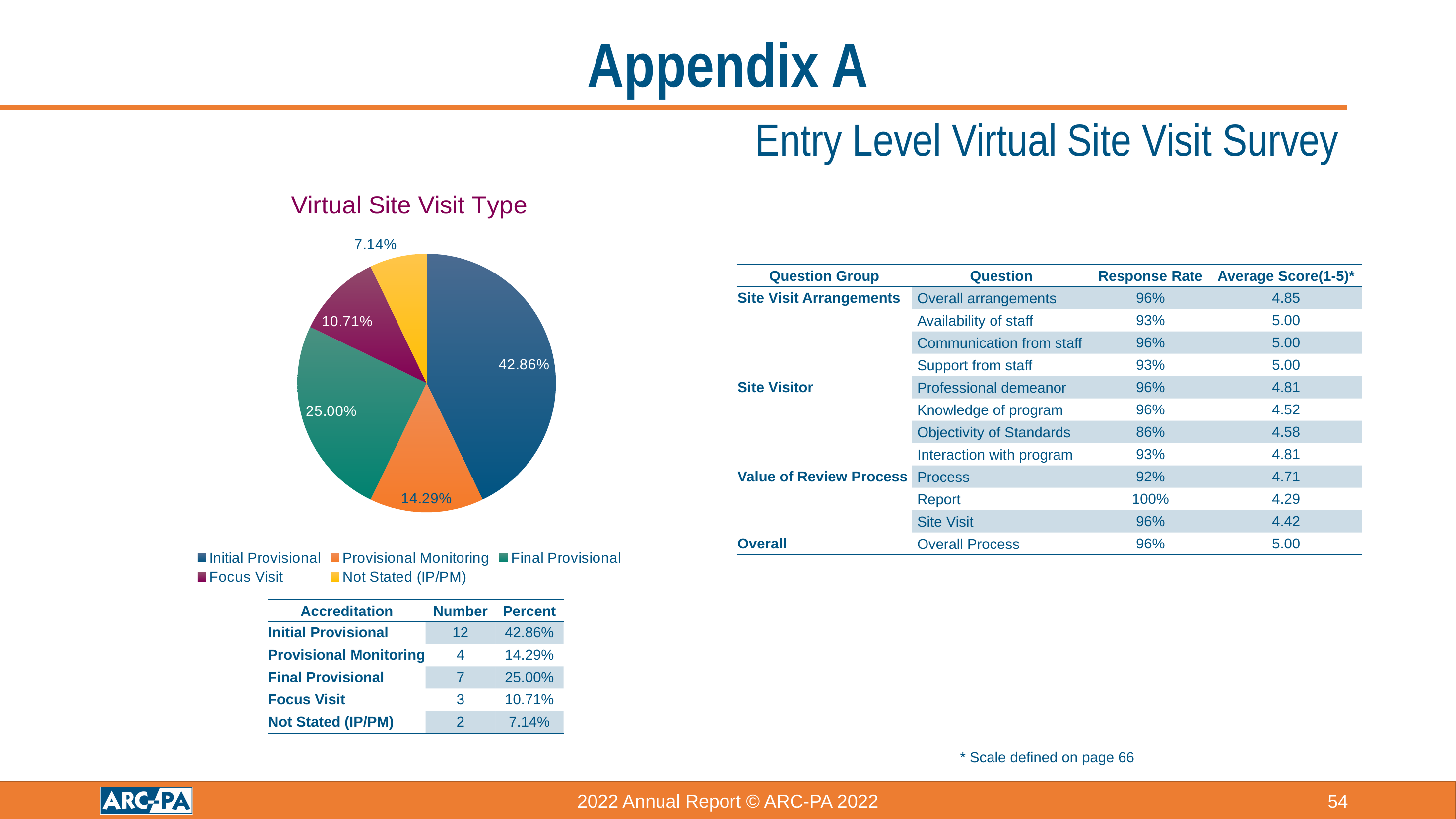
In the "Virtual Site Visit Type" chart, which slice is larger: Provisional Monitoring or Focus Visit? Provisional Monitoring Which category has the smallest slice in the "Virtual Site Visit Type" chart? Not Stated (IP/PM) Which category has the largest slice in the "Virtual Site Visit Type" chart? Initial Provisional What kind of chart is the "Virtual Site Visit Type" chart? pie chart How many slices does the "Virtual Site Visit Type" pie chart have? 5 What percentage does the Focus Visit slice show in the "Virtual Site Visit Type" chart? 10.71% What percentage does the Final Provisional slice show in the "Virtual Site Visit Type" chart? 25.00% What is the title of the pie chart on the slide? Virtual Site Visit Type What percentage does the Not Stated (IP/PM) slice show in the "Virtual Site Visit Type" chart? 7.14% In the "Virtual Site Visit Type" chart, what is the difference in percentage points between the Initial Provisional and Final Provisional slices? 17.86 What percentage does the Provisional Monitoring slice show in the "Virtual Site Visit Type" chart? 14.29% What percentage does the Initial Provisional slice show in the "Virtual Site Visit Type" chart? 42.86%